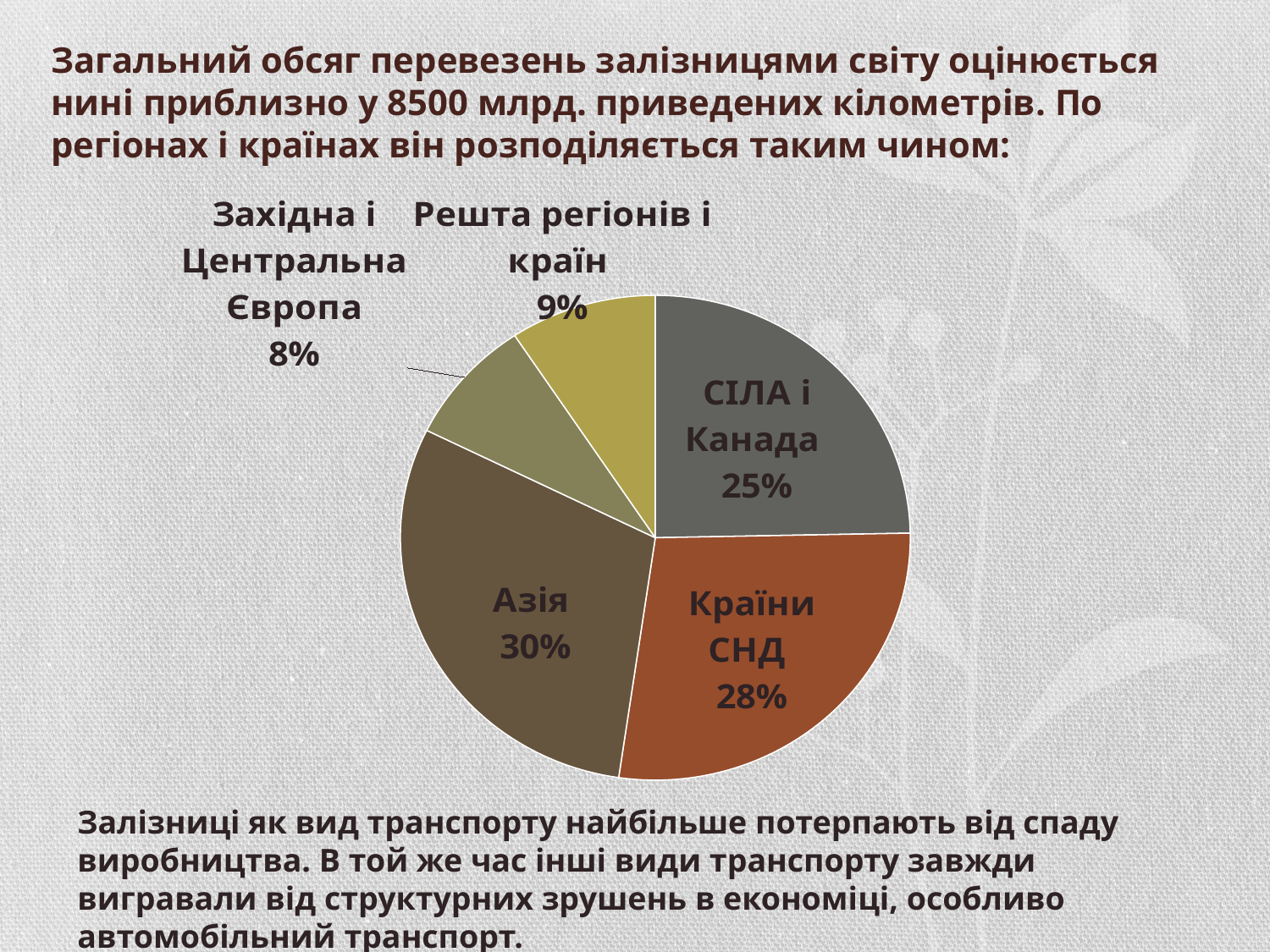
What is the difference in percentage points between the share for Решта регіонів і країн and the share for Західна і Центральна Європа? 1 How many slices does the pie chart have? 5 What share of the pie does Країни СНД have? 28% Which is larger, the share for Країни СНД or the share for США і Канада? Країни СНД What share of the pie does Решта регіонів і країн have? 9% Which region has the largest slice of the pie? Азія Which region has the smallest slice of the pie? Західна і Центральна Європа What share of the pie does США і Канада have? 25% What is the difference in percentage points between the share for Азія and the share for США і Канада? 5 What kind of chart is shown on the slide? pie chart